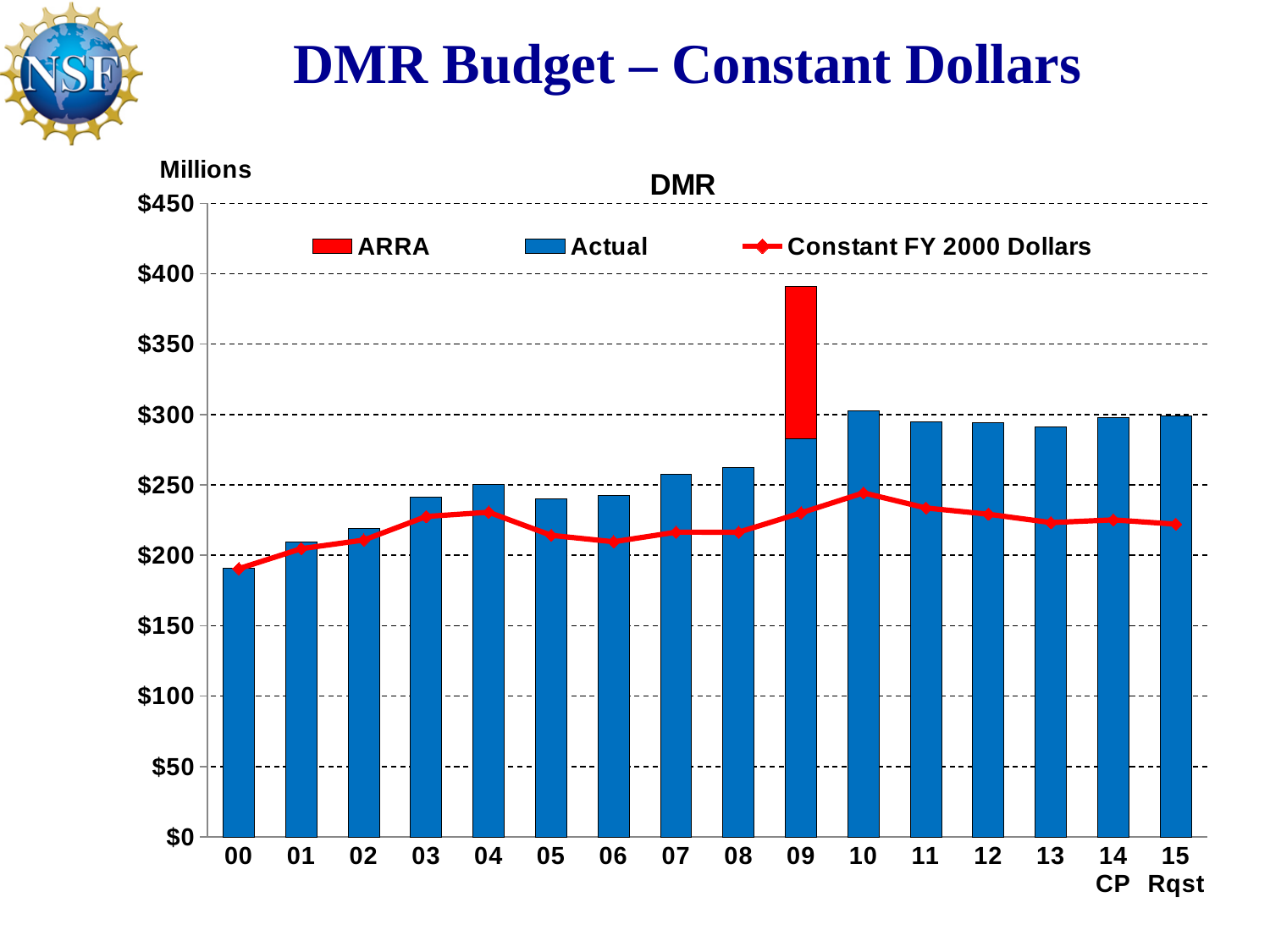
Which year is the only one with a red ARRA segment? 09 How many years are shown along the x axis? 16 Is the total bar for 09 greater or less than $350? greater Do the bars rise or fall from 00 to 04? rise In which year does the Constant FY 2000 Dollars line reach its highest point? 10 Is the bar for 00 greater or less than $200? less Is the bar for 03 greater or less than $250? less Which year has the tallest bar in total? 09 How many series does the legend list? 3 Which year has the shortest bar? 00 Which is larger, the bar for 08 or the bar for 03? 08